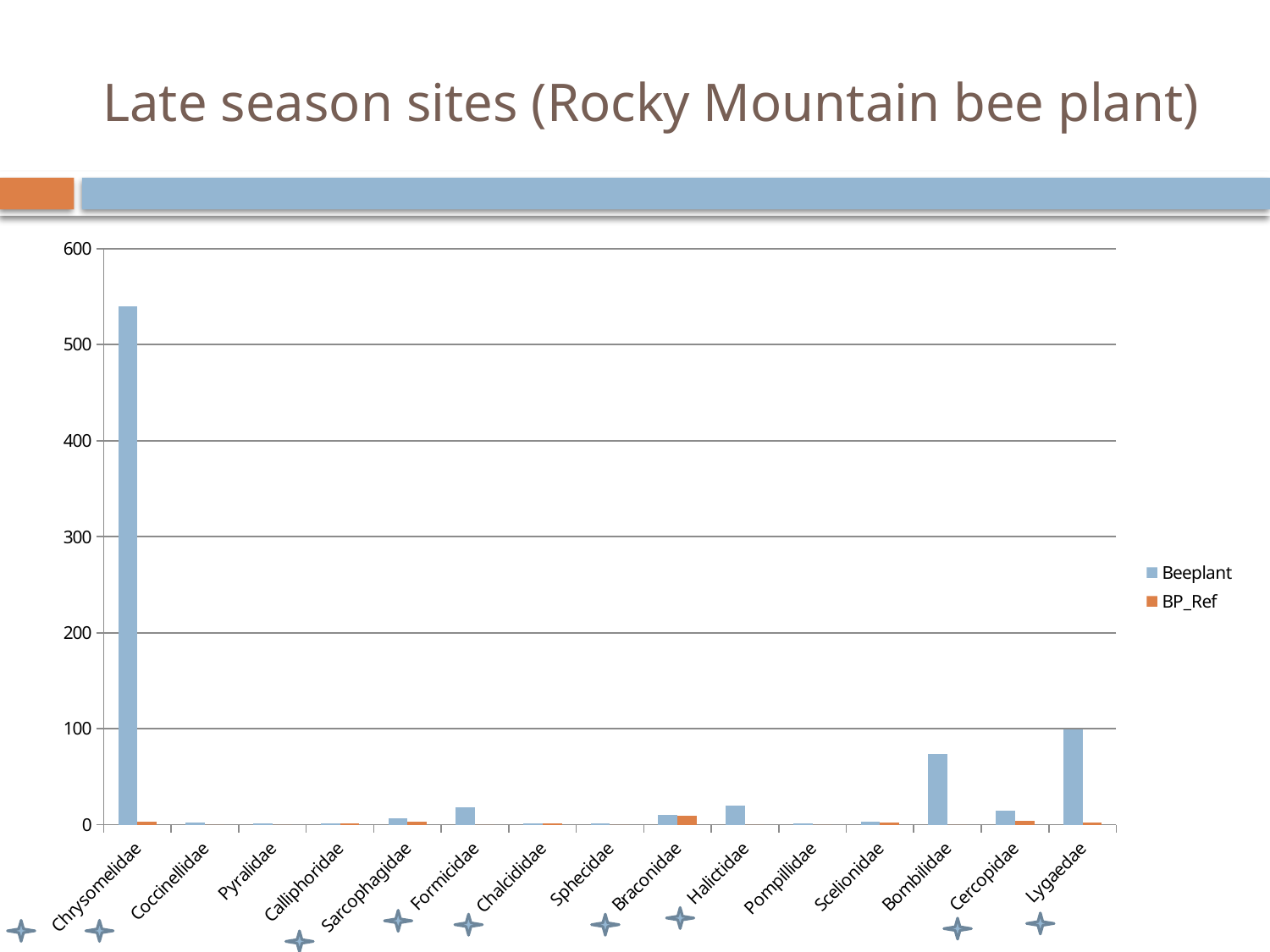
How many series does the legend list? 2 Which series has the larger value for Chrysomelidae, Beeplant or BP_Ref? Beeplant How many insect family categories are shown on the x axis? 15 What are the names of the two series in the legend? Beeplant and BP_Ref What kind of chart is shown on the slide? bar chart Which is larger, the Beeplant value for Bombilidae or the Beeplant value for Cercopidae? Bombilidae Which is larger, the Beeplant value for Chrysomelidae or the Beeplant value for Lygaedae? Chrysomelidae Is the Beeplant value for Bombilidae greater or less than 100? less Which category has the highest Beeplant value? Chrysomelidae What is the title of the slide containing the chart? Late season sites (Rocky Mountain bee plant) Is the Beeplant value for Halictidae greater or less than 100? less Is the Beeplant value for Chrysomelidae greater or less than 500? greater